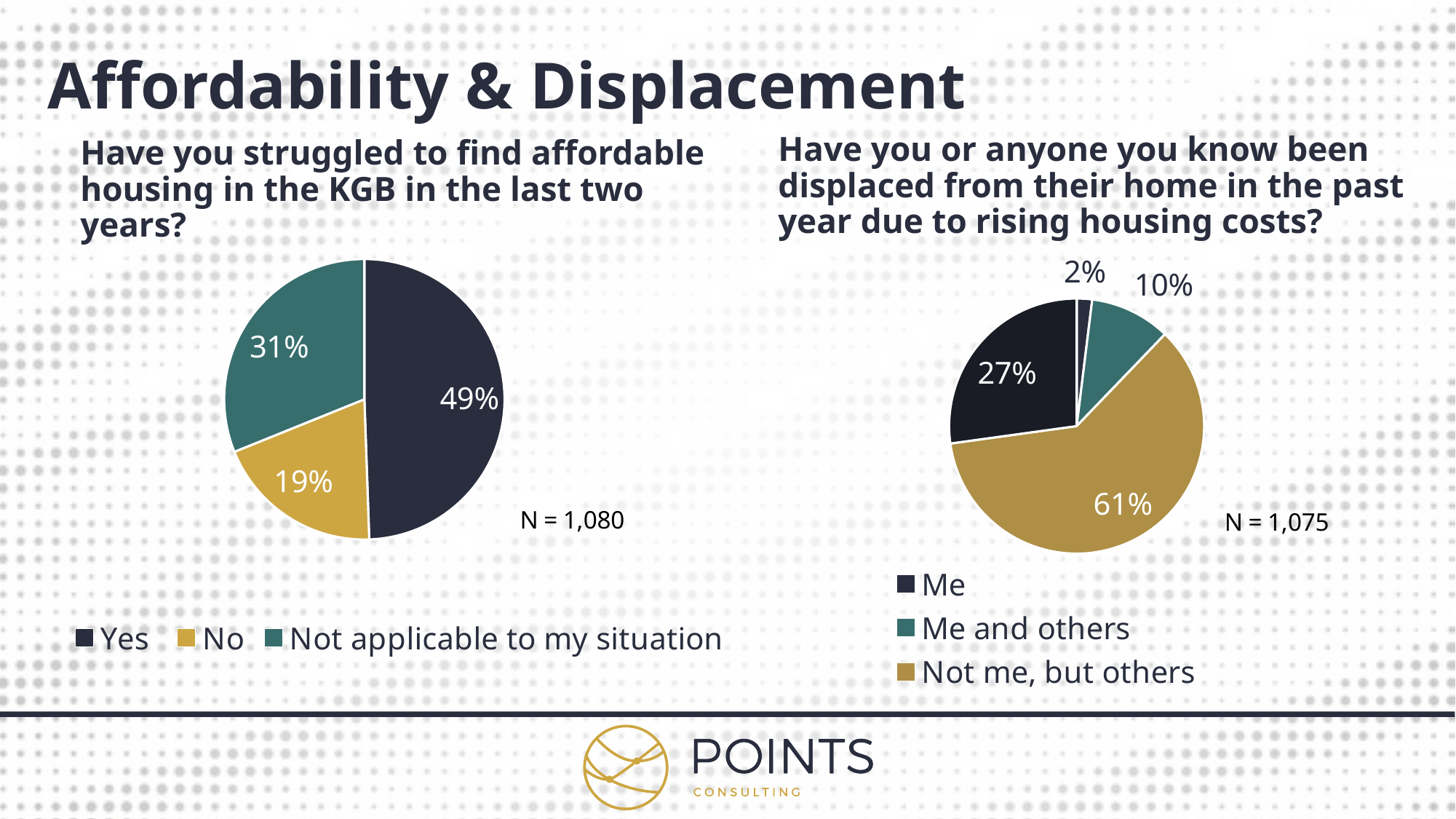
In the left pie chart about struggling to find affordable housing, which response has the largest share? Yes In the left pie chart about struggling to find affordable housing, what share of respondents answered Yes? 49% What type of chart is used for the question about struggling to find affordable housing? Pie chart In the left pie chart about struggling to find affordable housing, what is the difference in percentage points between Yes and No? 30 In the right pie chart about displacement due to rising housing costs, what share answered 'Not me, but others'? 61% In the right pie chart about displacement due to rising housing costs, what share answered 'Me and others'? 10% In the left pie chart about struggling to find affordable housing, what share answered 'Not applicable to my situation'? 31% In the left pie chart about struggling to find affordable housing, what share of respondents answered No? 19% In the left pie chart about struggling to find affordable housing, which response has the smallest share? No How many entries does the legend of the right pie chart about displacement list? 3